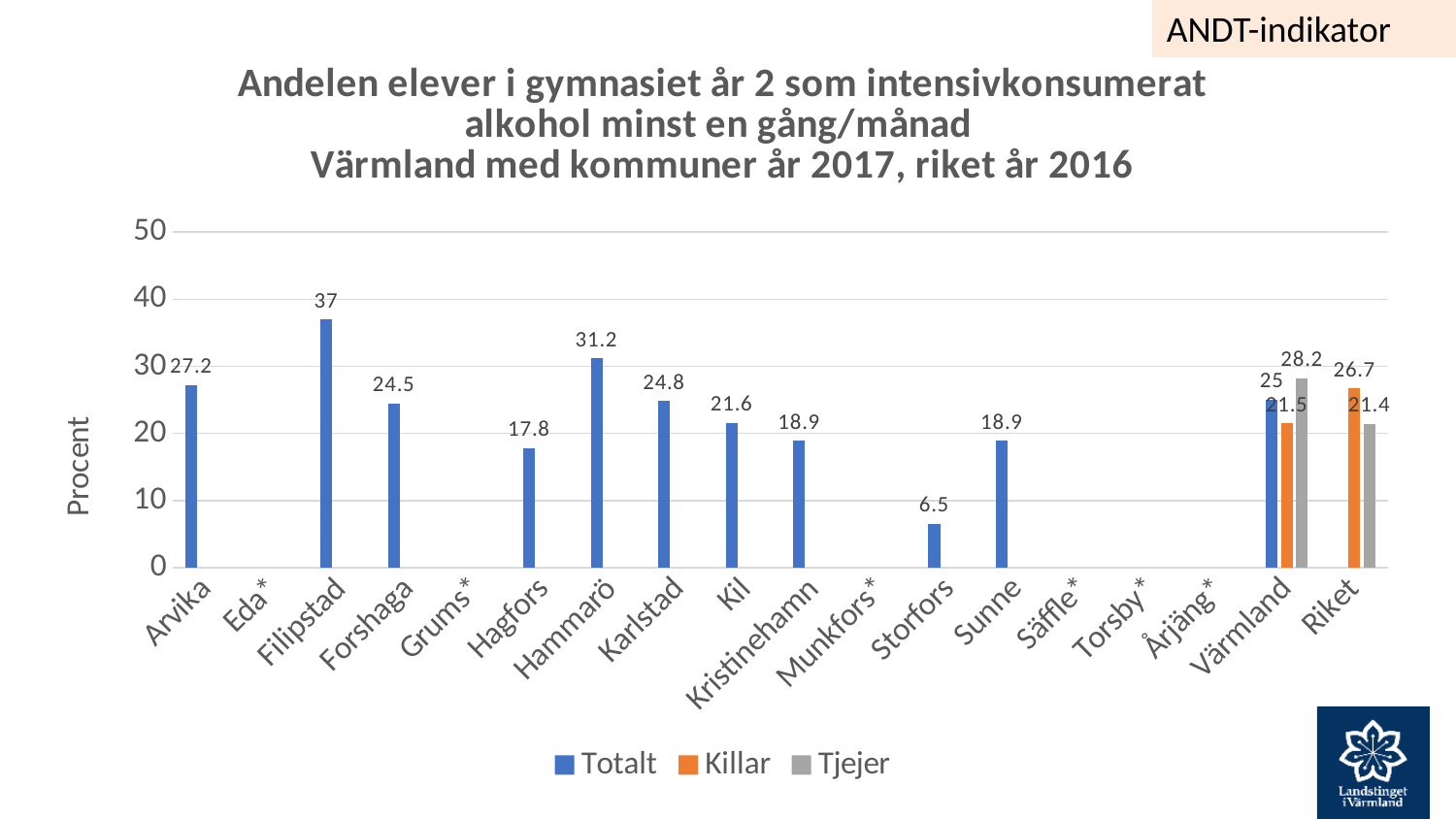
Which has a higher Totalt value, Hammarö or Karlstad? Hammarö What is the Totalt value for Filipstad? 37 What is the difference between the Totalt values for Arvika and Hagfors? 9.4 Which municipality has the highest Totalt value? Filipstad Which municipality has the lowest plotted Totalt value? Storfors How many series does the legend list? 3 How many categories are shown on the x axis? 18 What is the label on the y axis? Procent What is the Killar value for Riket? 26.7 What is the difference between the Tjejer and Killar values for Värmland? 6.7 What kind of chart is shown on the slide? Bar chart What is the Tjejer value for Värmland? 28.2